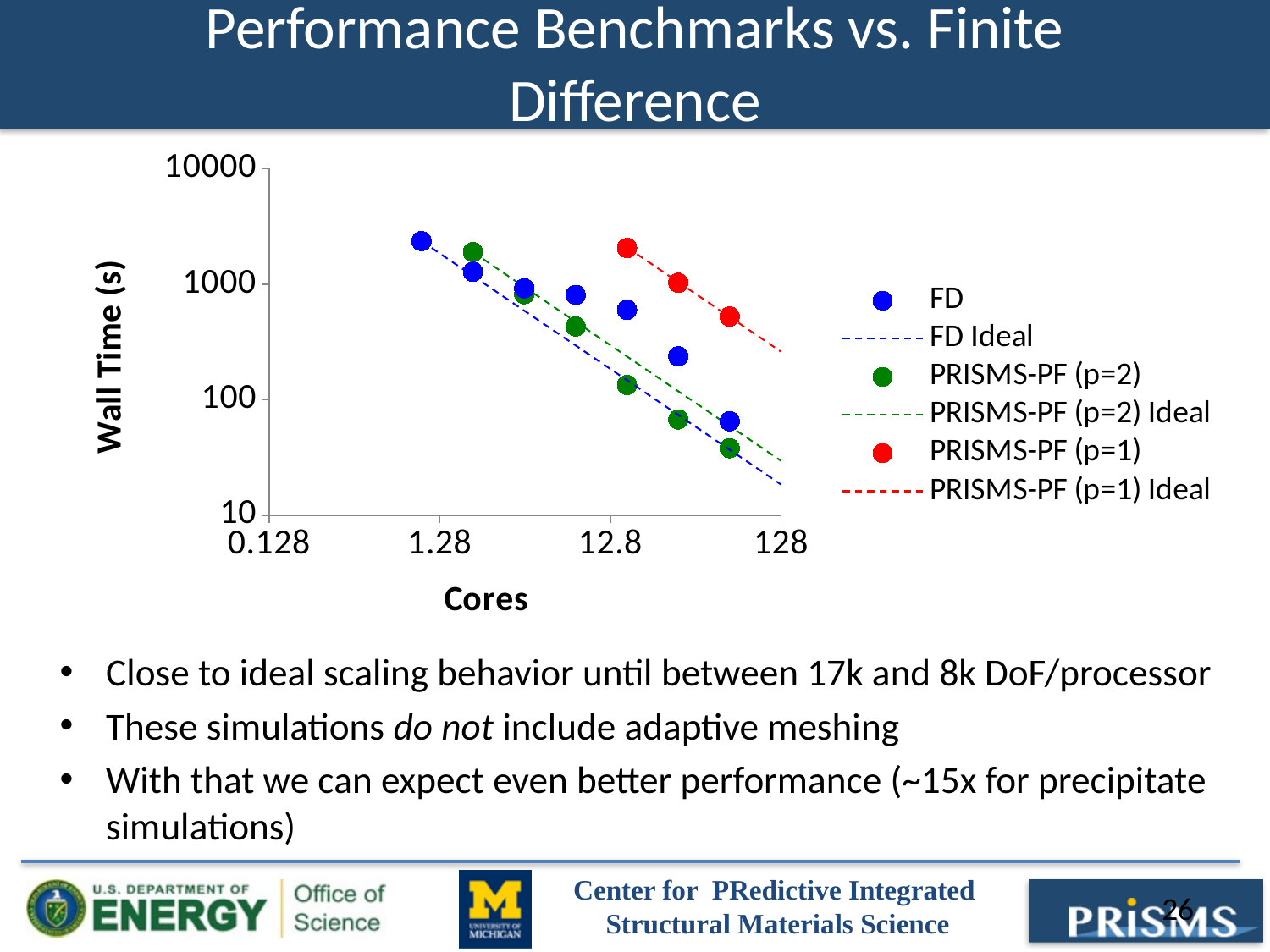
Is the lowest PRISMS-PF (p=2) wall time greater or less than 100? less At the largest number of cores plotted, which series has the lower wall time, FD or PRISMS-PF (p=2)? PRISMS-PF (p=2) What is the label of the vertical axis of the chart? Wall Time (s) Is the highest FD wall time greater or less than 1000? greater What kind of chart is shown on the slide? scatter chart How many series does the chart legend list? 6 What is the label of the horizontal axis of the chart? Cores How many FD data points are plotted on the chart? 7 How many PRISMS-PF (p=2) data points are plotted on the chart? 6 Is the lowest PRISMS-PF (p=1) wall time greater or less than 100? greater How many PRISMS-PF (p=1) data points are plotted on the chart? 3 Does the wall time for the FD series rise or fall as the number of cores increases? fall